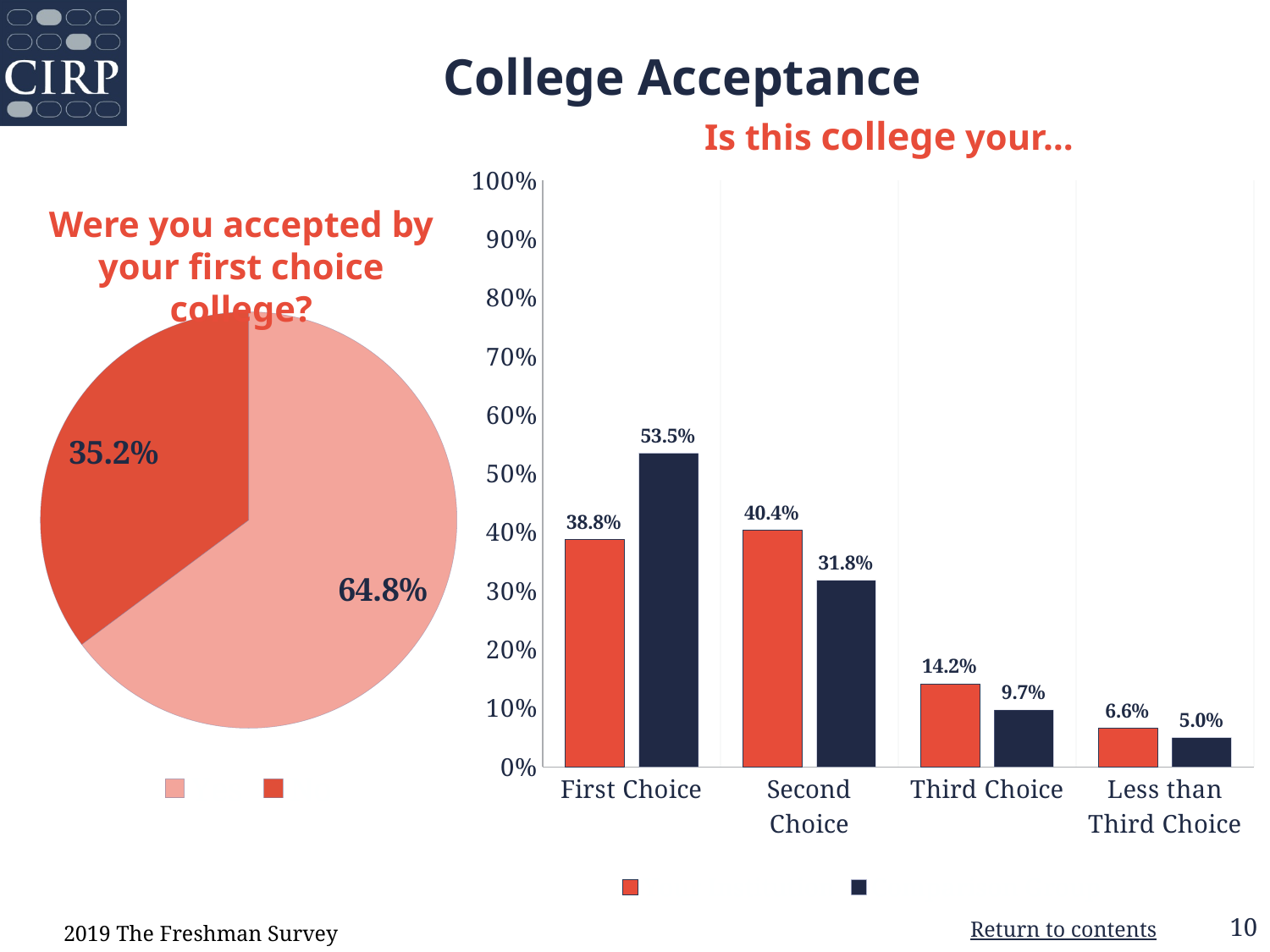
In the bar chart titled "Is this college your...", for Second Choice, which is larger: the red bar or the dark navy bar? The red bar In the bar chart titled "Is this college your...", how many categories are shown on the x axis? 4 In the bar chart titled "Is this college your...", what is the value of the dark navy bar for First Choice? 53.5% What type of chart is the chart on the left of the slide? Pie chart In the bar chart titled "Is this college your...", what is the value of the dark navy bar for Less than Third Choice? 5.0% In the bar chart titled "Is this college your...", do the dark navy bars rise or fall from First Choice to Less than Third Choice? Fall In the bar chart titled "Is this college your...", which category has the highest red bar? Second Choice In the bar chart titled "Is this college your...", how many series does the legend show? 2 In the bar chart titled "Is this college your...", what is the difference between the dark navy bar and the red bar for First Choice? 14.7% In the pie chart titled "Were you accepted by your first choice college?", what share does the larger, light pink slice represent? 64.8% In the bar chart titled "Is this college your...", what is the value of the red bar for First Choice? 38.8% In the bar chart titled "Is this college your...", which category has the lowest dark navy bar? Less than Third Choice